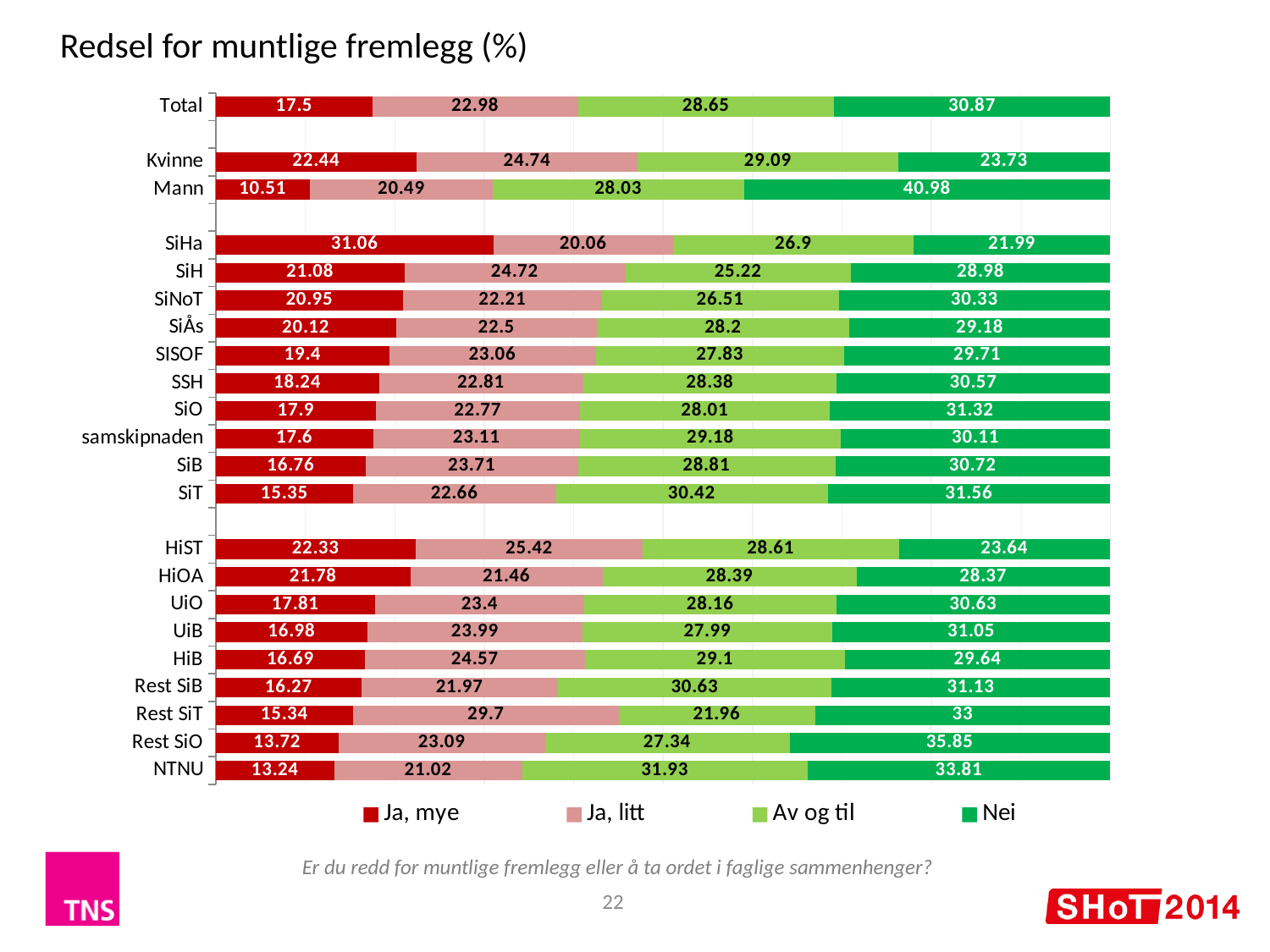
Which category has the lowest value for "Ja, mye"? Mann Which has a larger "Nei" value, Rest SiO or Rest SiT? Rest SiO What kind of chart is shown on the slide? Stacked bar chart What is the value of "Ja, litt" for Rest SiT? 29.7 What is the value of "Ja, mye" for Mann? 10.51 How many series does the legend list? 4 How many categories are plotted on the chart? 22 What is the value of "Nei" for NTNU? 33.81 Which category has the highest value for "Nei"? Mann Which category has the highest value for "Ja, mye"? SiHa What is the difference between the "Ja, mye" values for Kvinne and Mann? 11.93 What is the total of the stacked bar for Total? 100